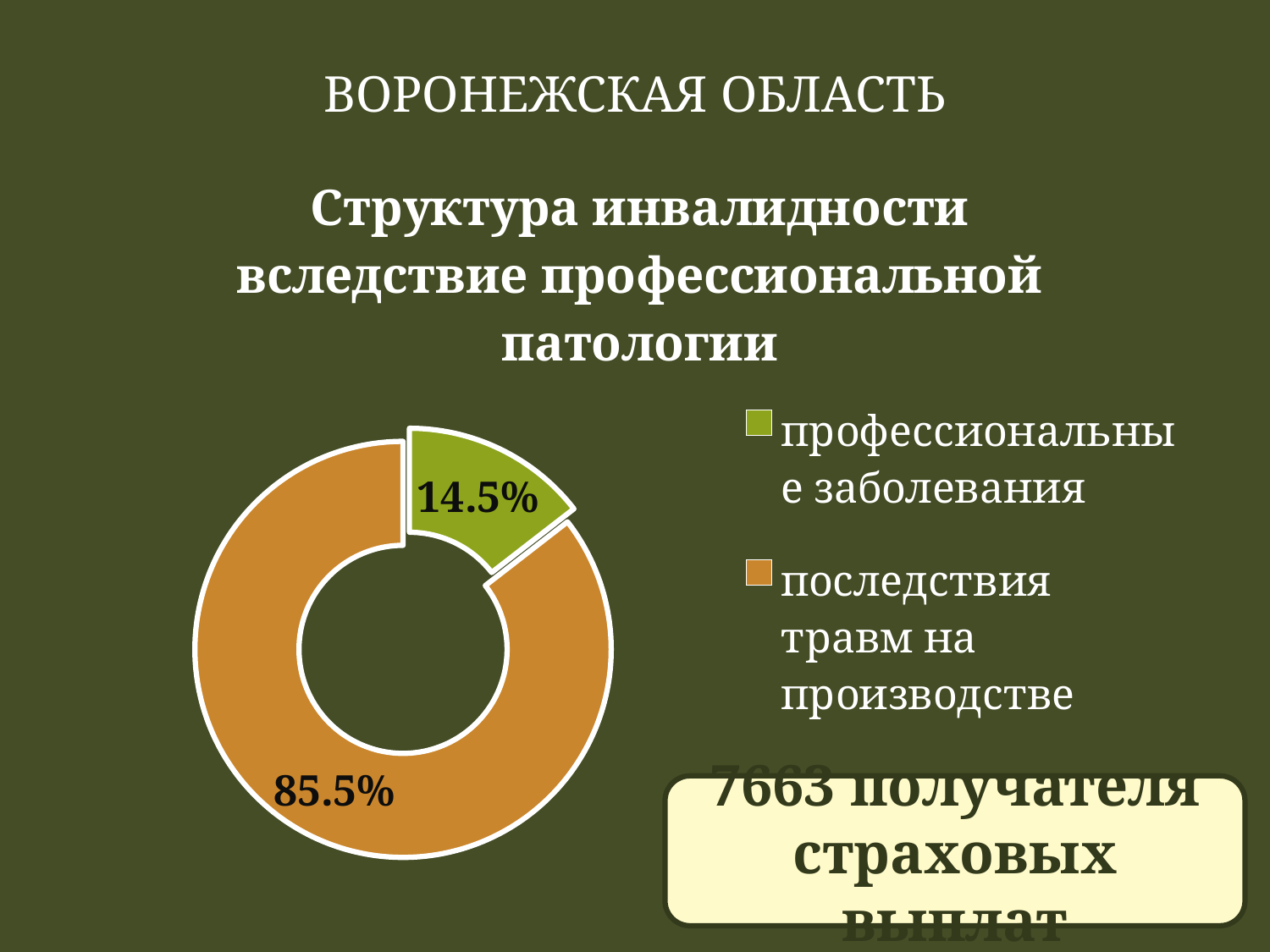
What is the difference in percentage points between the share for 'последствия травм на производстве' and the share for 'профессиональные заболевания'? 71 percentage points How many categories does the chart show? 2 Which category has the largest share of the chart? последствия травм на производстве What is the title of the chart? Структура инвалидности вследствие профессиональной патологии What kind of chart is shown on the slide? Doughnut (pie) chart What share of the chart is labelled 'последствия травм на производстве'? 85.5% What share of the chart is labelled 'профессиональные заболевания'? 14.5% What colour is the slice for 'профессиональные заболевания'? Green Which category has the smallest share of the chart? профессиональные заболевания How many entries does the legend list? 2 Which is larger: the share for 'профессиональные заболевания' or the share for 'последствия травм на производстве'? последствия травм на производстве Is the share for 'профессиональные заболевания' greater or less than 50%? less